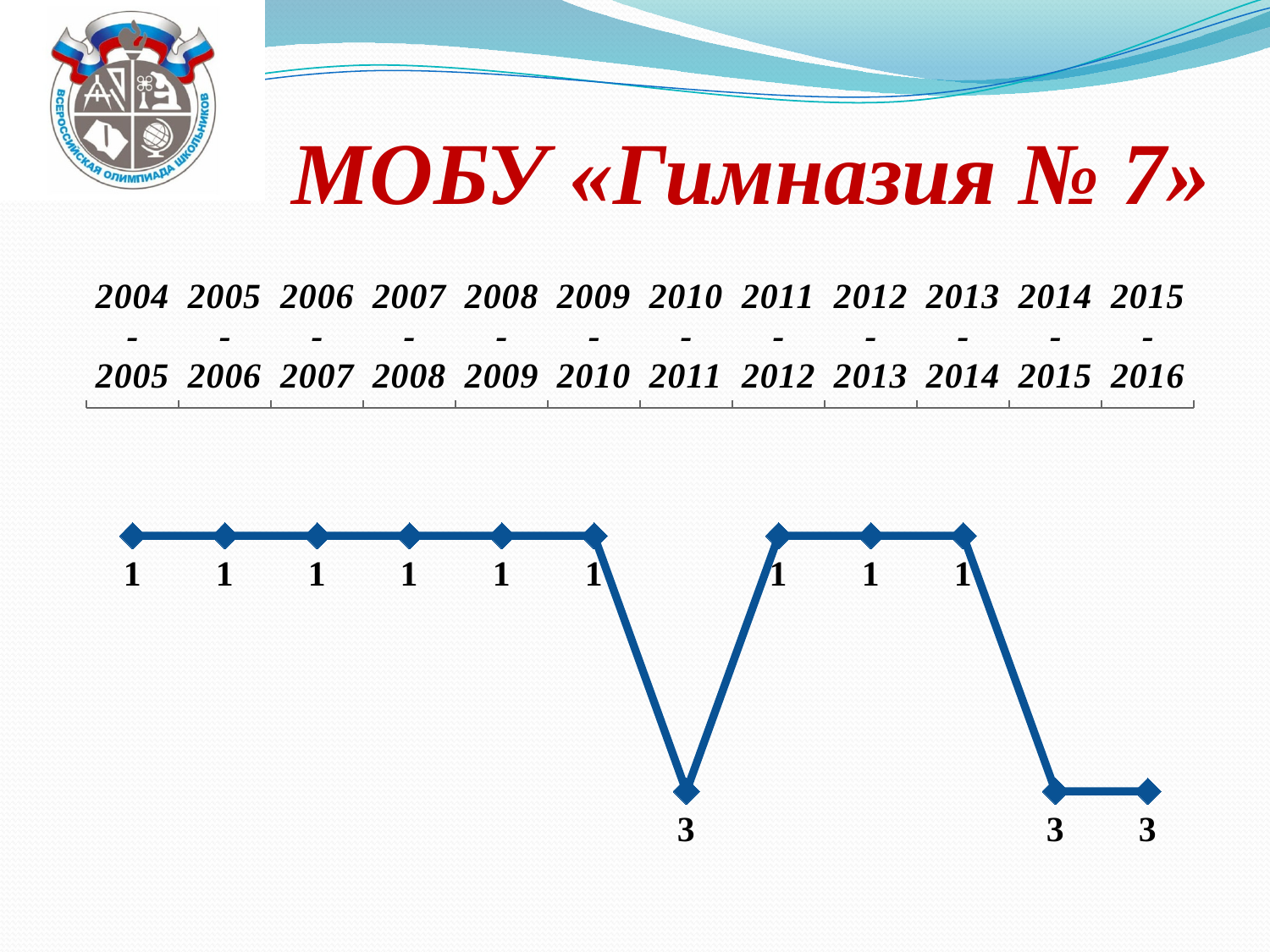
How many data points have the value 3? 3 What is the difference between the values for 2015-2016 and 2014-2015? 0 Which has the larger plotted value, 2014-2015 or 2012-2013? 2014-2015 What is the value plotted for 2010-2011? 3 What is the value plotted for 2004-2005? 1 What is the title shown on the slide above the chart? МОБУ «Гимназия № 7» What is the difference between the values for 2010-2011 and 2009-2010? 2 What kind of chart is shown on the slide? line chart What is the value plotted for 2011-2012? 1 What is the value plotted for 2013-2014? 1 How many school-year categories are plotted on the x axis? 12 What is the value plotted for 2015-2016? 3